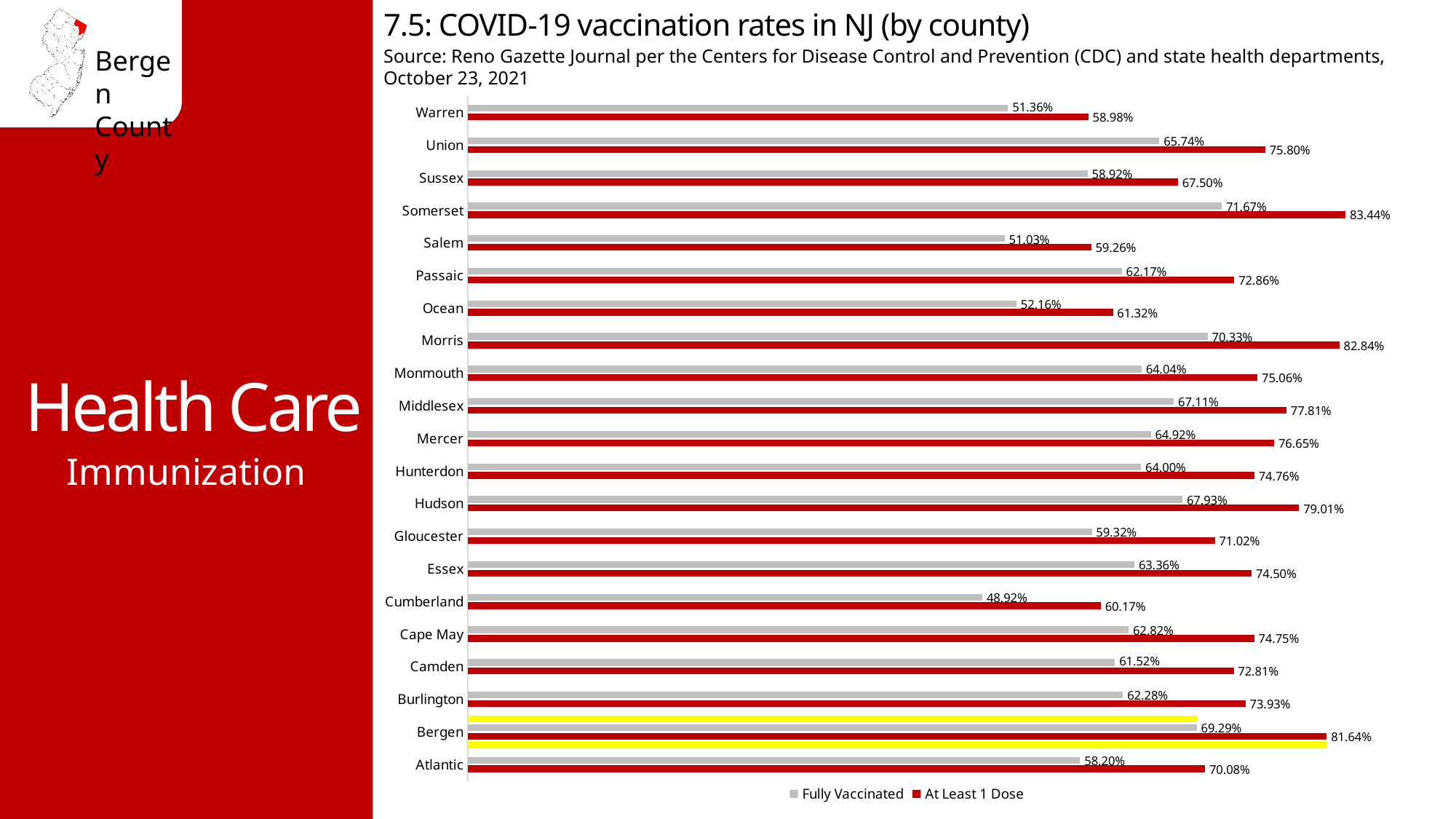
How many counties are shown in the chart? 21 What is the At Least 1 Dose rate for Somerset county? 83.44% Which county has the lowest Fully Vaccinated rate? Cumberland What is the Fully Vaccinated rate for Cumberland county? 48.92% Which county has the lowest At Least 1 Dose rate? Warren Which series is shown in red in the chart? At Least 1 Dose What type of chart is shown on the slide? Bar chart How many series does the legend list? 2 What is the difference between the At Least 1 Dose rate and the Fully Vaccinated rate for Bergen county? 12.35% Which county has the highest At Least 1 Dose rate? Somerset Which county has a higher Fully Vaccinated rate, Hudson or Essex? Hudson What is the Fully Vaccinated rate for Bergen county? 69.29%